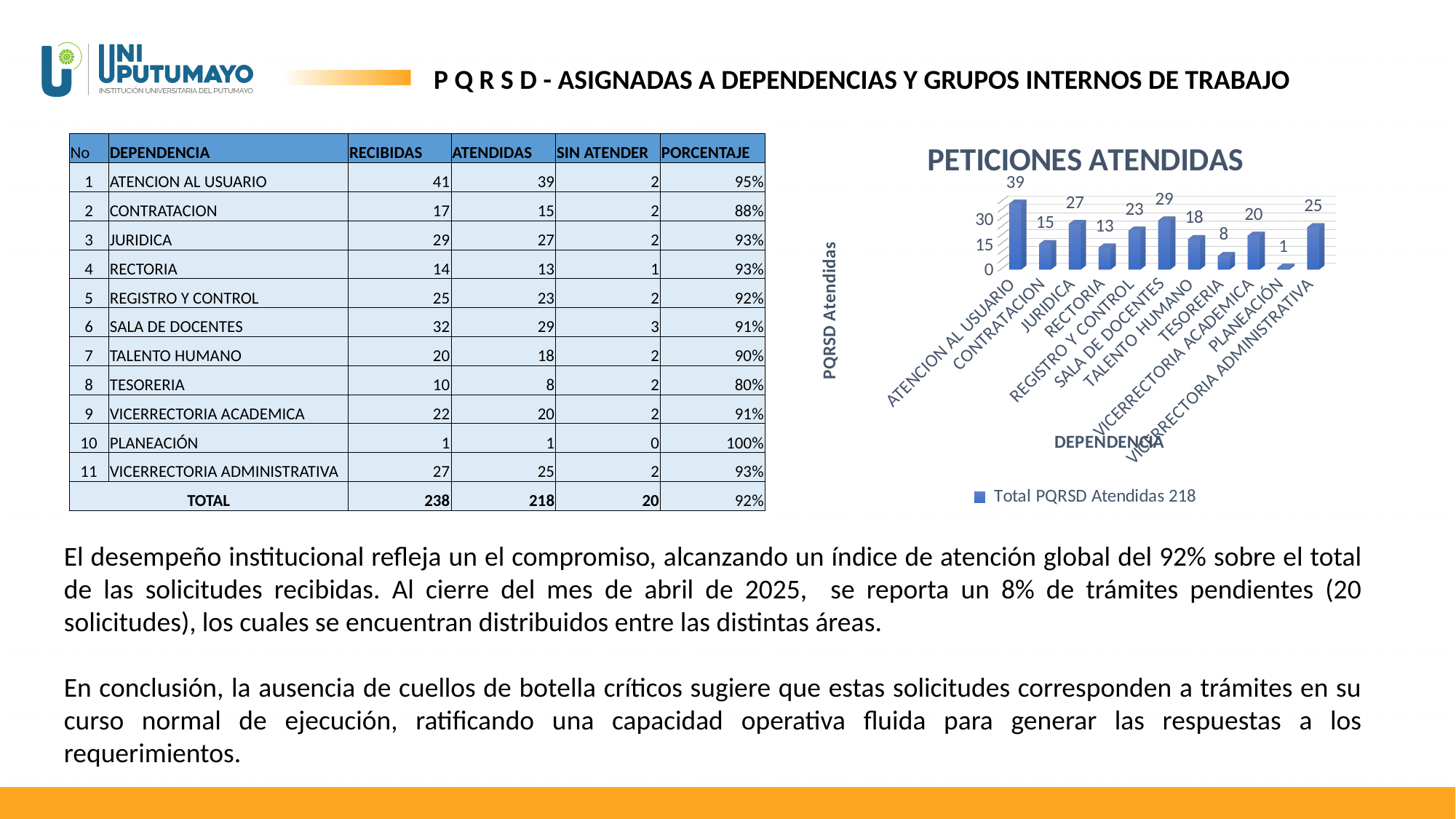
What type of chart is shown on the slide? bar chart Is the value for VICERRECTORIA ADMINISTRATIVA greater or less than 15? greater Which dependencia has the lowest value in the chart? PLANEACIÓN How many series does the chart legend list? 1 What is the value for TALENTO HUMANO in the chart? 18 Which is larger, the value for SALA DE DOCENTES or the value for REGISTRO Y CONTROL? SALA DE DOCENTES Which dependencia has the highest value in the chart? ATENCION AL USUARIO What is the title of the chart? PETICIONES ATENDIDAS How many categories (dependencias) are plotted in the chart? 11 What is the legend entry shown below the chart? Total PQRSD Atendidas 218 What is the value for JURIDICA in the chart? 27 What is the difference between the values for ATENCION AL USUARIO and TESORERIA? 31